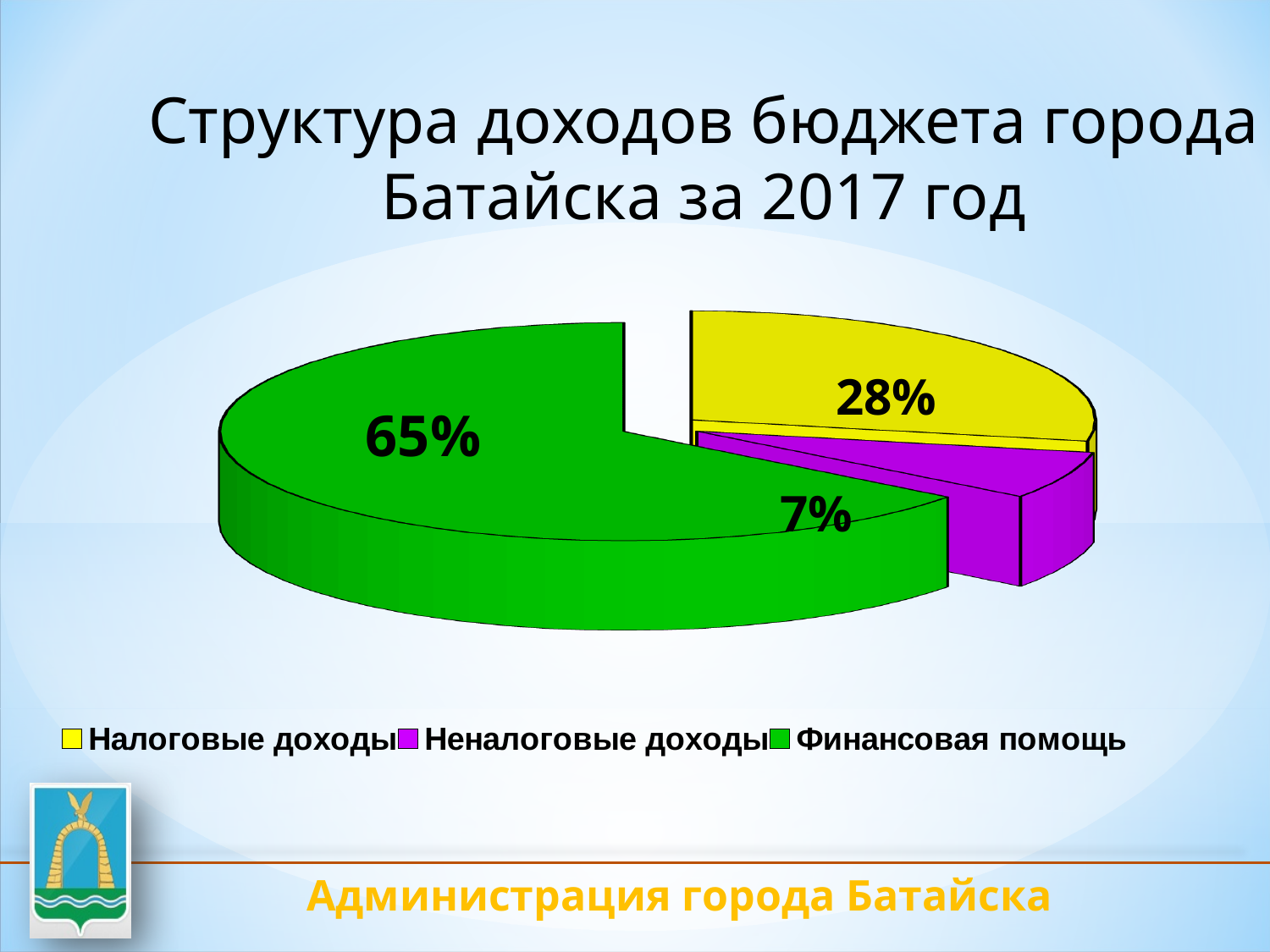
What share of the pie does Налоговые доходы represent? 28% What is the title of the chart? Структура доходов бюджета города Батайска за 2017 год What kind of chart is shown on the slide? pie chart What is the difference in percentage points between Налоговые доходы and Неналоговые доходы? 21 What is the difference in percentage points between Финансовая помощь and Налоговые доходы? 37 What colour is the slice for Неналоговые доходы? purple Which category has the smallest slice of the pie? Неналоговые доходы What share of the pie does Неналоговые доходы represent? 7% Which category has the largest slice of the pie? Финансовая помощь How many categories are shown in the pie chart? 3 What share of the pie does Финансовая помощь represent? 65% Which is larger, the share for Налоговые доходы or the share for Неналоговые доходы? Налоговые доходы